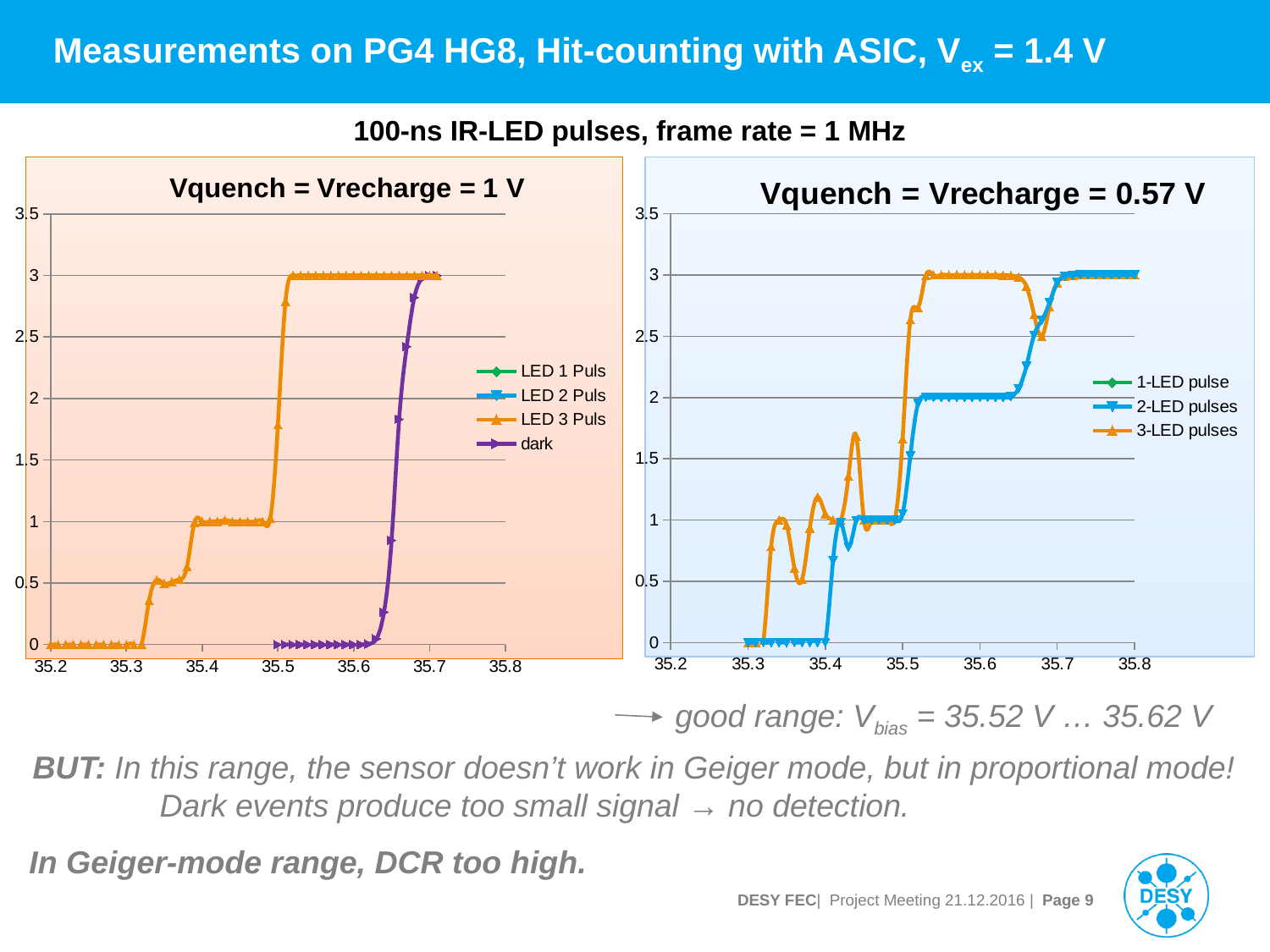
In the left chart (Vquench = Vrecharge = 1 V), does the LED 3 Puls series overall rise or fall as the x-axis value increases from 35.2 to 35.8? rise In the right chart (Vquench = Vrecharge = 0.57 V), is the value of the 2-LED pulses series at 35.35 greater or less than 0.5? less How many series does the legend of the right chart (Vquench = Vrecharge = 0.57 V) list? 3 In the left chart (Vquench = Vrecharge = 1 V), is the value of the dark series at 35.55 greater or less than 0.5? less In the left chart (Vquench = Vrecharge = 1 V), is the value of the LED 3 Puls series at 35.6 greater or less than 2? greater Which series in the left chart (Vquench = Vrecharge = 1 V) is drawn in purple? dark What kind of chart is the left chart titled "Vquench = Vrecharge = 1 V"? line chart How many series does the legend of the left chart (Vquench = Vrecharge = 1 V) list? 4 What is the title of the right chart? Vquench = Vrecharge = 0.57 V